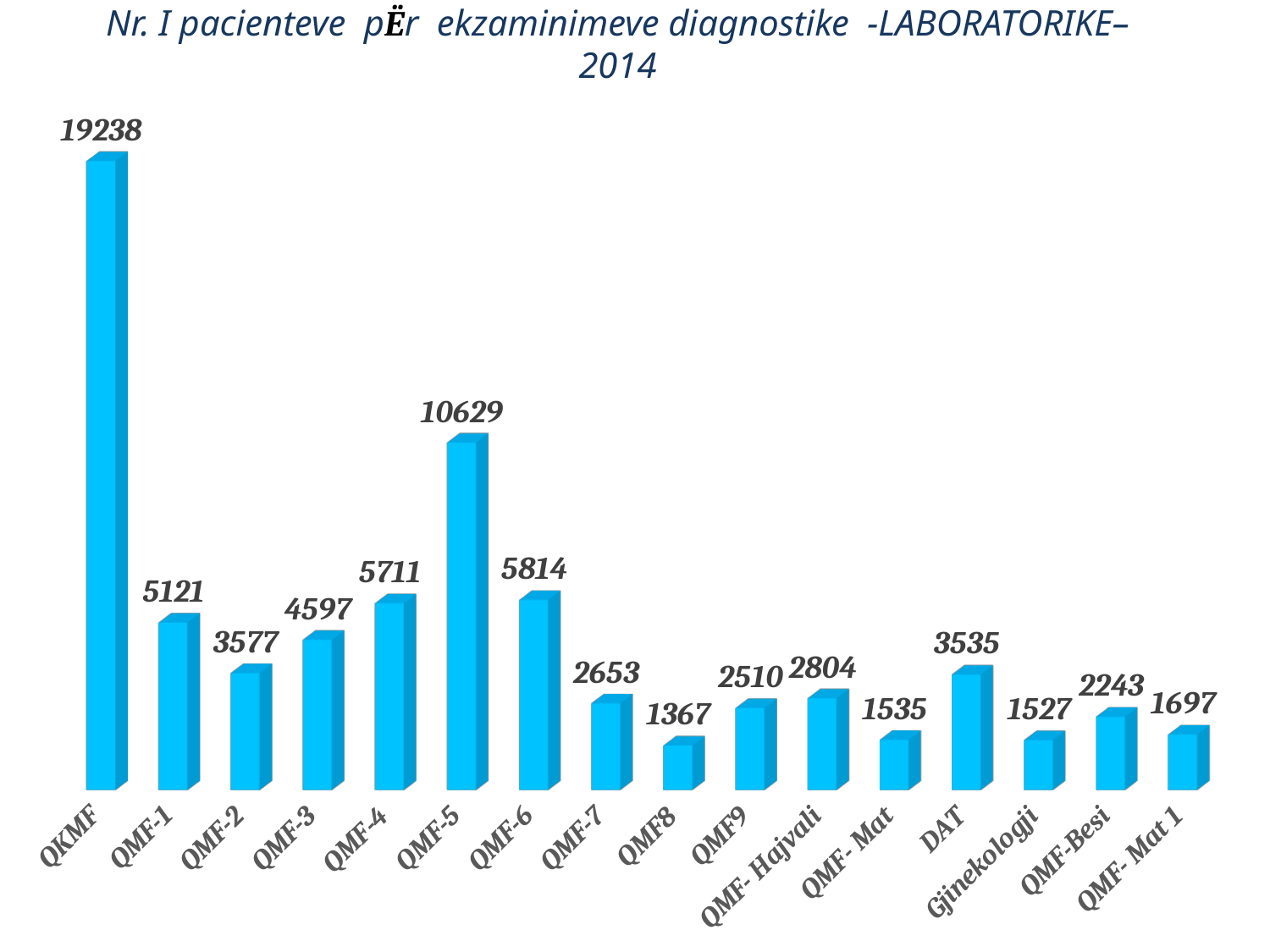
What is the value for QMF- Hajvali? 2804 Which category has the lowest value? QMF8 What is the difference between the values for QMF-1 and QMF-2? 1544 Which category has the highest value? QKMF What year is mentioned in the chart title? 2014 What is the value for QKMF? 19238 What is the value for Gjinekologji? 1527 Which has a larger value, QMF-3 or QMF-2? QMF-3 What kind of chart is shown on the slide? Bar chart What is the difference between the values for QKMF and QMF-5? 8609 How many categories are shown on the chart? 16 What is the value for QMF-5? 10629